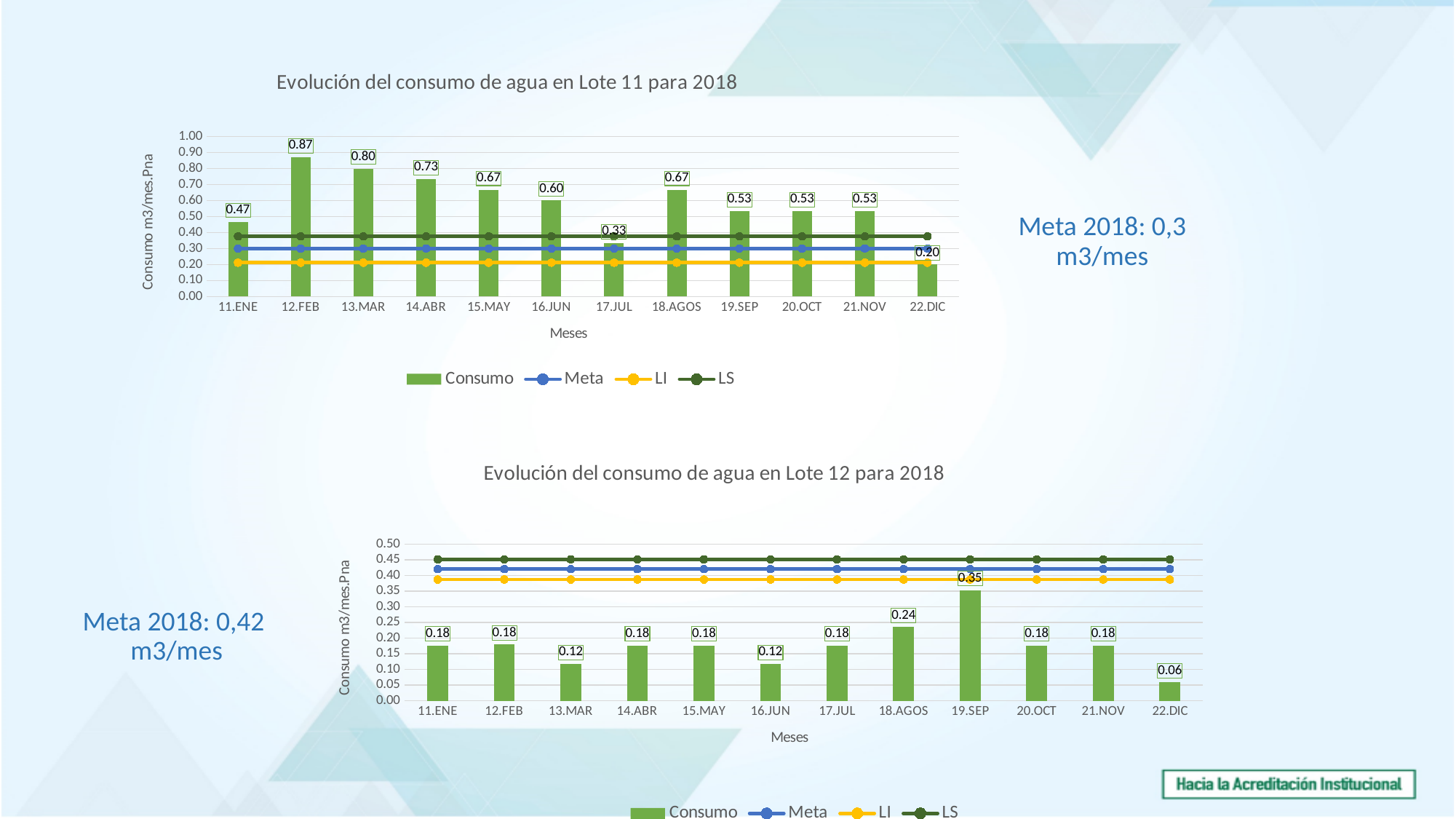
In the chart 'Evolución del consumo de agua en Lote 12 para 2018', how many months are shown on the x axis? 12 In the chart 'Evolución del consumo de agua en Lote 12 para 2018', which month has the lowest Consumo value? 22.DIC In the chart 'Evolución del consumo de agua en Lote 12 para 2018', which is larger, the Consumo value for 18.AGOS or for 13.MAR? 18.AGOS In the chart 'Evolución del consumo de agua en Lote 11 para 2018', what is the difference between the Consumo values for 13.MAR and 17.JUL? 0.47 In the chart 'Evolución del consumo de agua en Lote 12 para 2018', what is the Consumo value for 19.SEP? 0.35 What is the label on the y axis of the chart 'Evolución del consumo de agua en Lote 12 para 2018'? Consumo m3/mes.Pna In the chart 'Evolución del consumo de agua en Lote 11 para 2018', is the Consumo value for 11.ENE greater or less than 0.40? greater In the chart 'Evolución del consumo de agua en Lote 11 para 2018', how many series does the legend list? 4 In the chart 'Evolución del consumo de agua en Lote 11 para 2018', which month has the highest Consumo value? 12.FEB In the chart 'Evolución del consumo de agua en Lote 11 para 2018', which month has the lowest Consumo value? 22.DIC In the chart 'Evolución del consumo de agua en Lote 11 para 2018', what is the Consumo value for 12.FEB? 0.87 In the chart 'Evolución del consumo de agua en Lote 12 para 2018', what is the difference between the Consumo values for 19.SEP and 22.DIC? 0.29